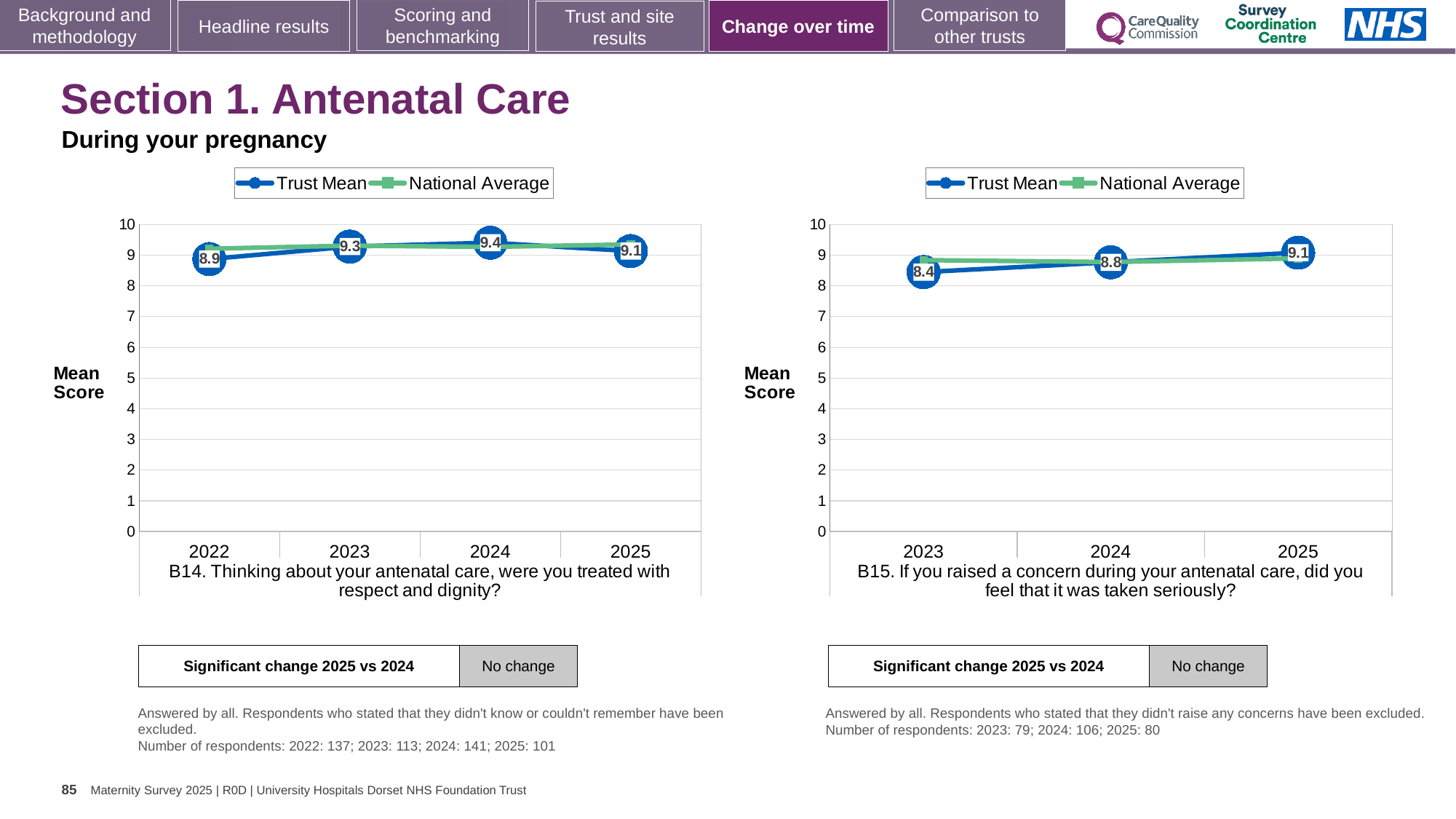
In the B14 chart (left), what is the difference between the Trust Mean for 2024 and 2022? 0.5 In the B15 chart (right), what is the Trust Mean for 2023? 8.4 In the B14 chart (left), which year has the lowest Trust Mean? 2022 In the B15 chart (right), what is the difference between the Trust Mean for 2025 and 2023? 0.7 In the B15 chart (right), does the Trust Mean rise or fall from 2023 to 2025? rise What kind of chart is the B14 chart on the left? line chart In the B14 chart (left), which year has the highest Trust Mean? 2024 In the B15 chart (right), how many series does the legend list? 2 In the B14 chart (left), what is the Trust Mean for 2024? 9.4 In the B15 chart (right), what is the Trust Mean for 2025? 9.1 In the B14 chart (left), how many years are shown on the x axis? 4 In the B14 chart (left), what is the Trust Mean for 2022? 8.9